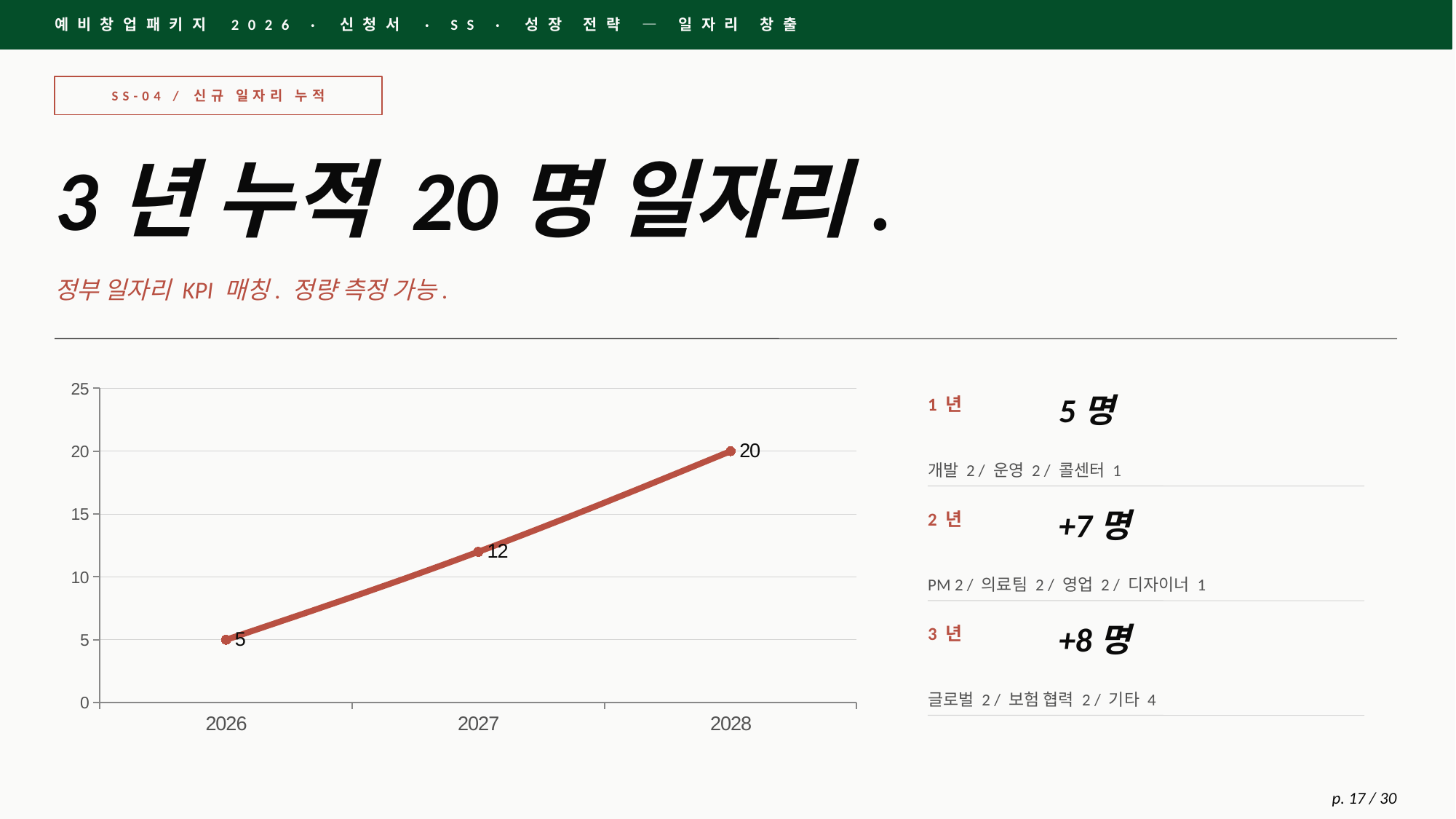
What is the value for 2028? 20 What is the difference between the values for 2028 and 2026? 15 Which year has the highest value? 2028 What kind of chart is shown on the slide? line chart Which year has the lowest value? 2026 Is the value for 2027 greater or less than 10? greater Which is larger, the value for 2027 or the value for 2028? 2028 What is the difference between the values for 2027 and 2026? 7 What is the value for 2027? 12 Do the values rise or fall from 2026 to 2028? rise How many data points are plotted on the chart? 3 What is the value for 2026? 5